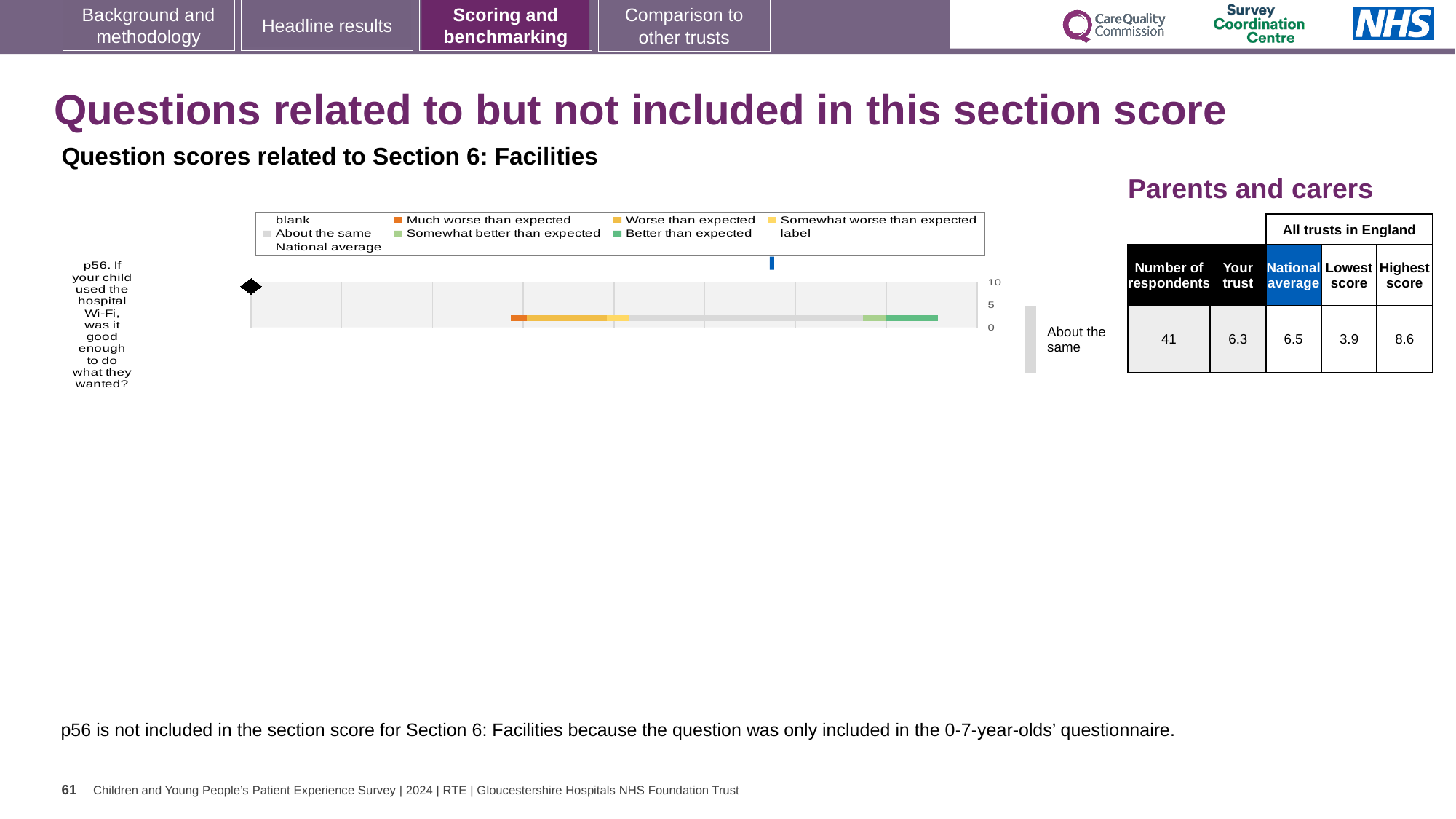
According to the table beside the chart, what is the lowest score among all trusts in England for p56? 3.9 What is the difference between the highest score and the lowest score for p56 in the table beside the chart? 4.7 Which question is plotted in the chart? p56. If your child used the hospital Wi-Fi, was it good enough to do what they wanted? According to the table beside the chart, what is the national average score for p56? 6.5 According to the table beside the chart, what is the highest score among all trusts in England for p56? 8.6 Is the national average marker for p56 on the chart greater or less than 5? greater What kind of chart is shown on the slide? bar chart What colour does the legend use for 'Much worse than expected'? orange According to the table beside the chart, what is the 'Your trust' score for p56? 6.3 According to the table beside the chart, how many respondents answered p56? 41 How many questions (categories) are plotted in the chart? 1 Which is larger for p56: the 'Your trust' score or the national average? National average